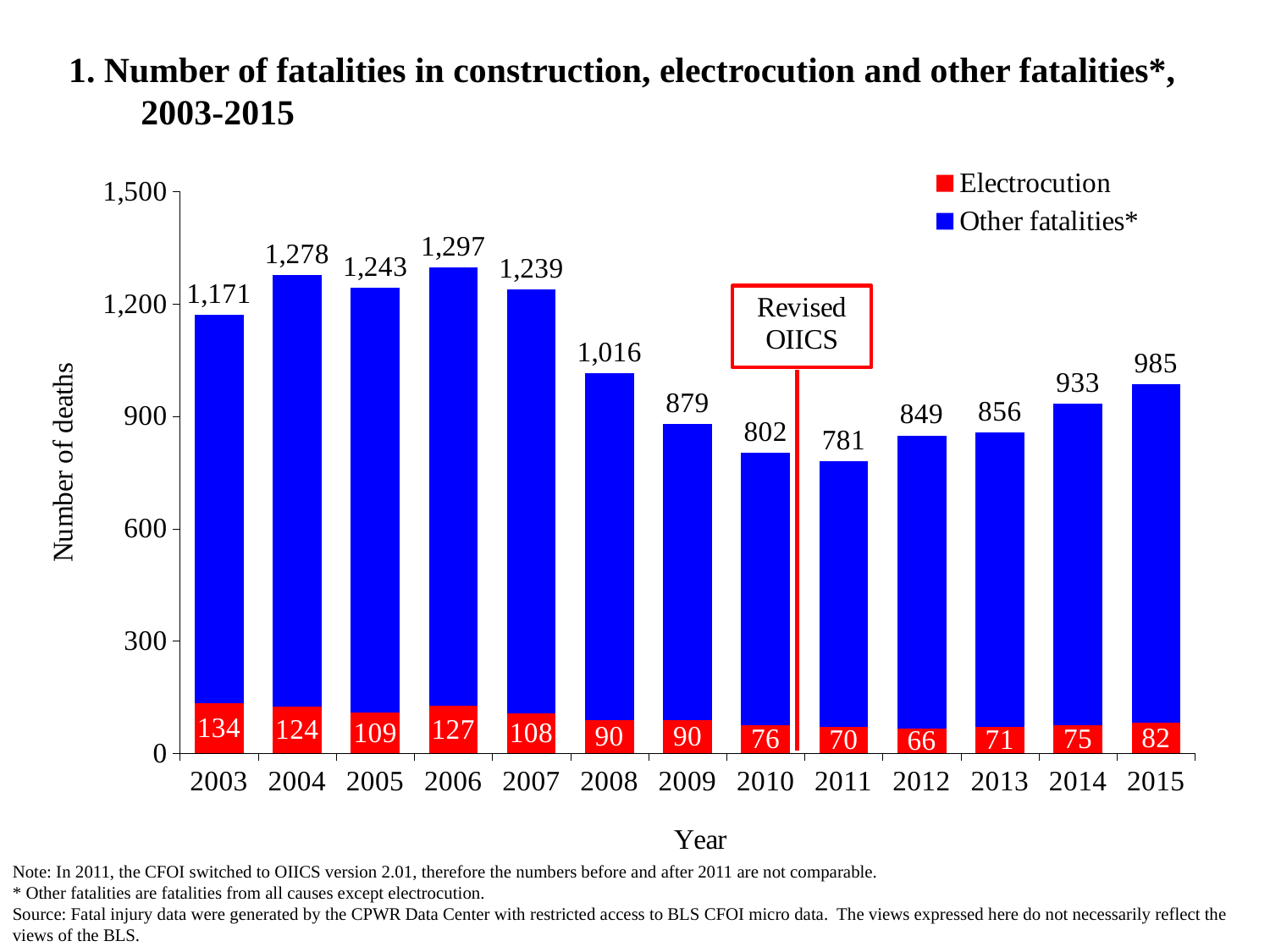
How many series does the legend list? 2 How many years are shown on the x axis? 13 Which year had the lowest number of electrocution fatalities? 2012 How many electrocution fatalities were there in 2003? 134 Which year had the lowest total number of deaths? 2011 Do the total deaths rise or fall from 2011 to 2015? Rise How many more electrocution fatalities were there in 2003 than in 2015? 52 What kind of chart is shown on the slide? Stacked bar chart Which year had a higher total number of deaths, 2014 or 2015? 2015 What is the total number of deaths shown for 2006? 1,297 Which year had the highest number of electrocution fatalities? 2003 Which year had the highest total number of deaths? 2006